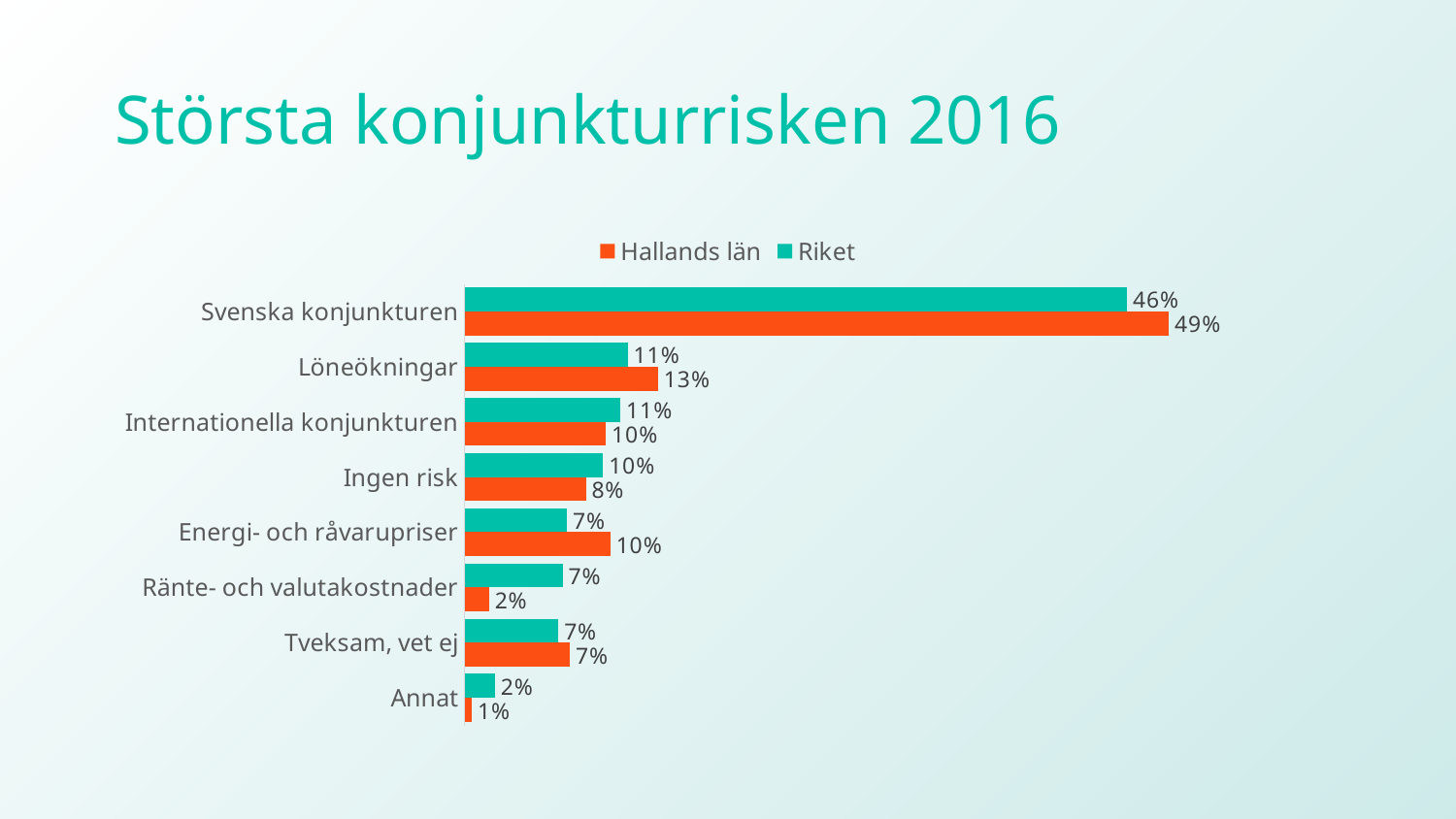
What is the difference between the Hallands län and Riket values for Svenska konjunkturen? 3% Which category has the lowest value for Hallands län? Annat Which is larger for Energi- och råvarupriser, Hallands län or Riket? Hallands län Which category has the highest value for Riket? Svenska konjunkturen What is the value for Riket for Löneökningar? 11% What is the value for Hallands län for Svenska konjunkturen? 49% How many categories are shown on the chart? 8 How many series does the legend list? 2 What is the title of the slide? Största konjunkturrisken 2016 Which colour represents Riket in the chart? Teal (green) What kind of chart is shown on the slide? Bar chart What is the value for Hallands län for Ränte- och valutakostnader? 2%